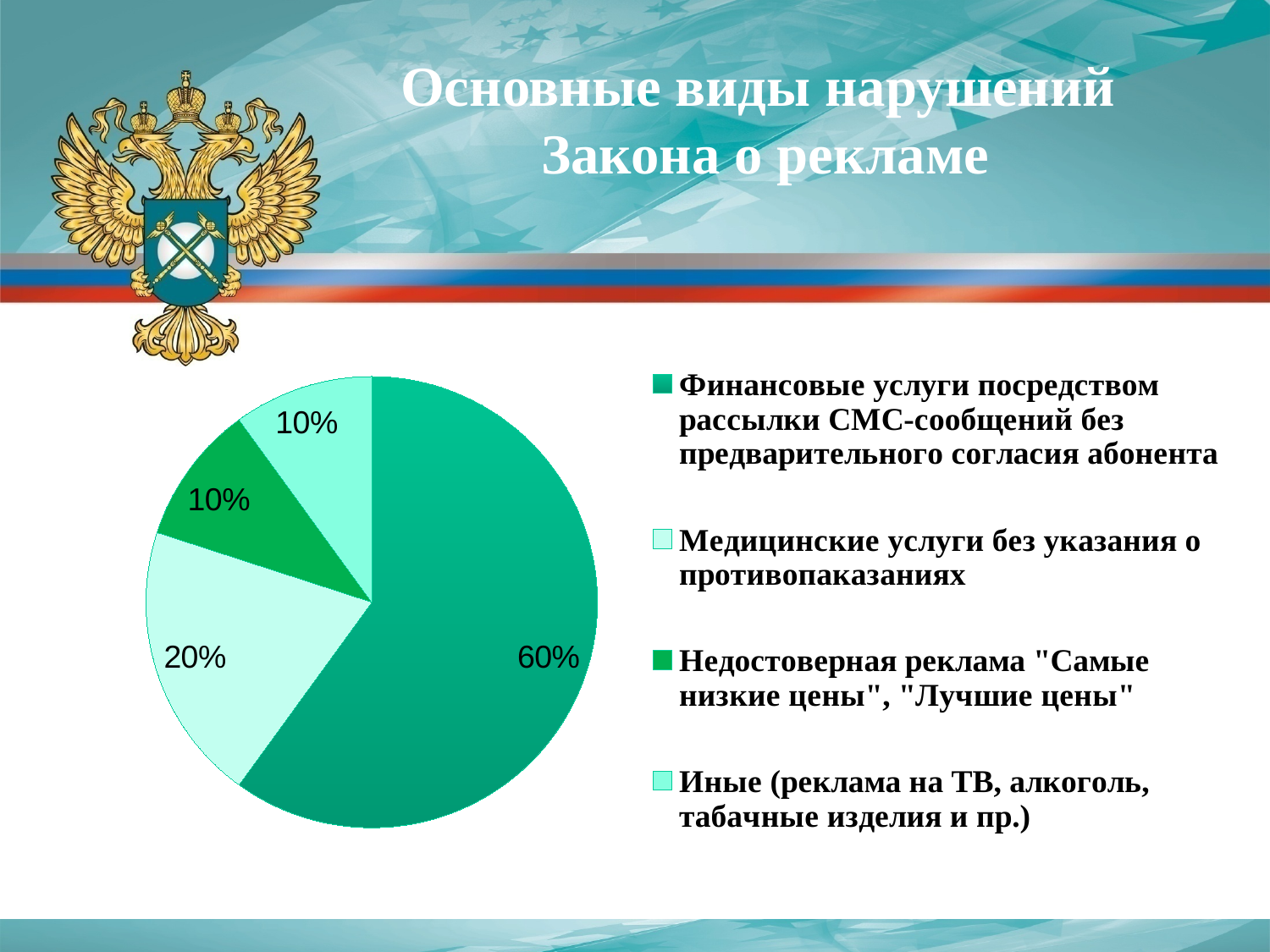
What is the smallest percentage shown on the pie chart? 10% How many slices does the pie chart have? 4 What share of the pie is 'Медицинские услуги без указания о противопоказаниях'? 20% Which is larger: the share for 'Медицинские услуги без указания о противопоказаниях' or the share for 'Иные (реклама на ТВ, алкоголь, табачные изделия и пр.)'? Медицинские услуги без указания о противопоказаниях What share of the pie is 'Иные (реклама на ТВ, алкоголь, табачные изделия и пр.)'? 10% What kind of chart is shown on the slide? pie chart How many entries does the legend list? 4 Which category has the largest slice of the pie? Финансовые услуги посредством рассылки СМС-сообщений без предварительного согласия абонента What share of the pie is 'Финансовые услуги посредством рассылки СМС-сообщений без предварительного согласия абонента'? 60% What is the difference between the share for 'Финансовые услуги посредством рассылки СМС-сообщений' and the share for 'Медицинские услуги без указания о противопоказаниях'? 40% What is the title of the slide containing the chart? Основные виды нарушений Закона о рекламе